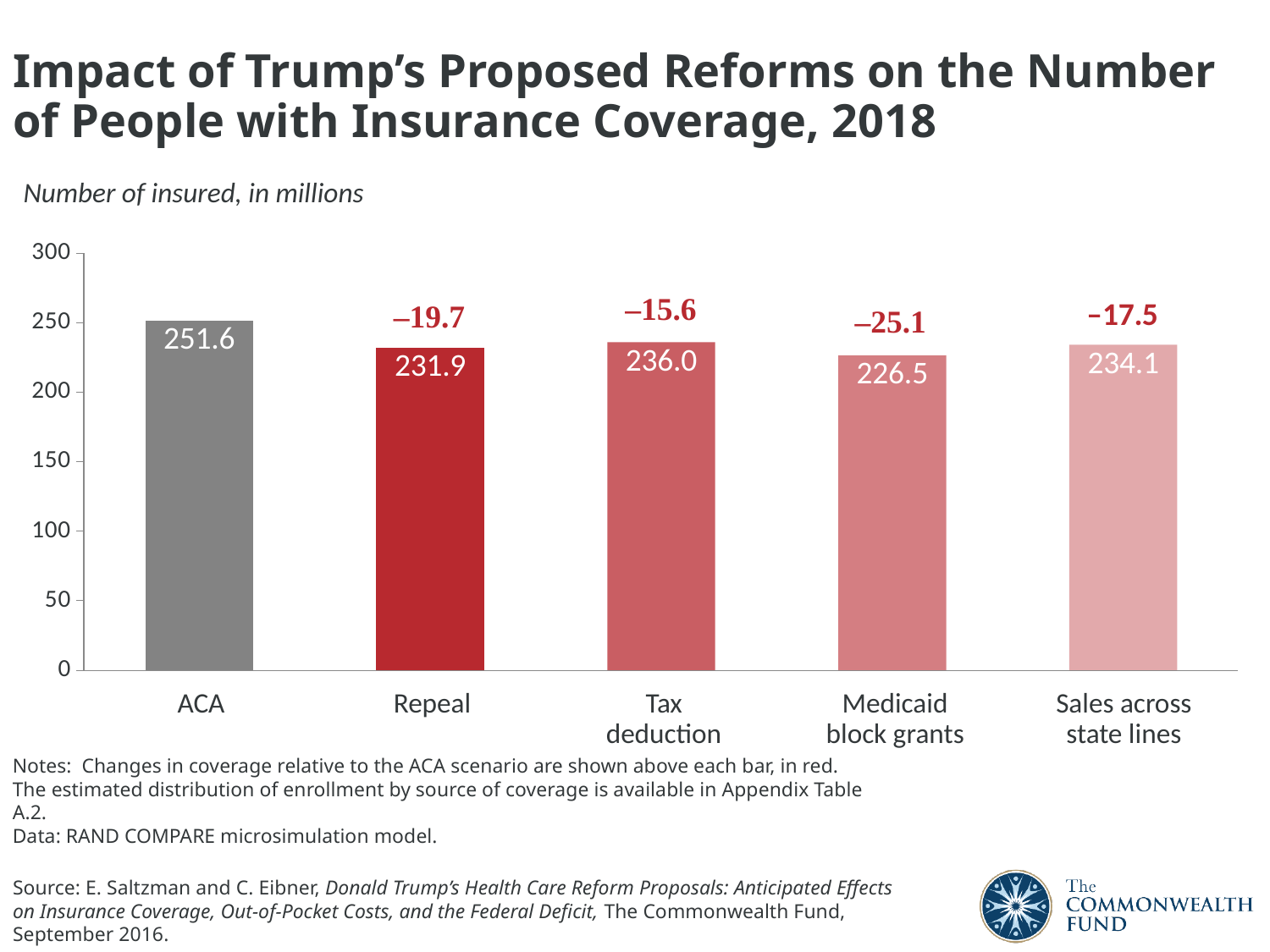
What kind of chart is shown on the slide? Bar chart In what colour are the changes in coverage relative to the ACA shown above each bar? Red What is the difference in millions of insured between the ACA and Repeal scenarios? 19.7 How many scenarios are shown on the chart? 5 Which scenario has the lowest number of insured? Medicaid block grants Is the value for Repeal greater or less than 250? less What is the number of insured, in millions, under the Medicaid block grants scenario? 226.5 What change in coverage relative to the ACA is shown above the Repeal bar? –19.7 What is the number of insured, in millions, under the ACA scenario? 251.6 What is the difference in millions of insured between Tax deduction and Medicaid block grants? 9.5 Which scenario has the highest number of insured? ACA Which has more insured people: Tax deduction or Sales across state lines? Tax deduction